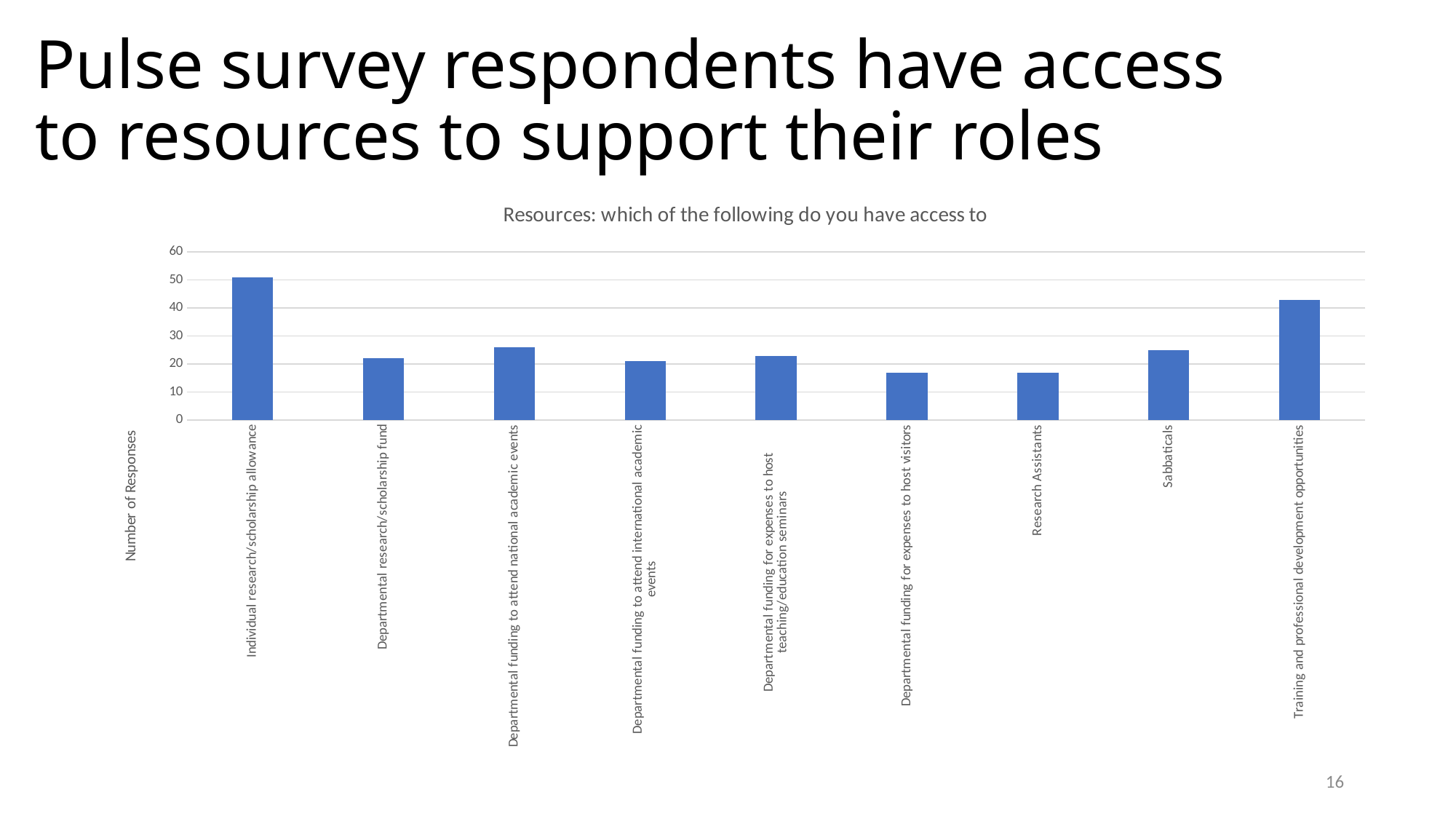
Is the value for Departmental funding to attend national academic events greater or less than 30? less What kind of chart is shown on the slide? bar chart Which has more responses: Sabbaticals or Research Assistants? Sabbaticals Is the value for Sabbaticals greater or less than 20? greater Is the value for Individual research/scholarship allowance greater or less than 40? greater How many resource categories are plotted on the chart? 9 Which resource category has the highest number of responses? Individual research/scholarship allowance What is the title of the chart? Resources: which of the following do you have access to What is the label on the vertical axis of the chart? Number of Responses Which has more responses: Individual research/scholarship allowance or Training and professional development opportunities? Individual research/scholarship allowance